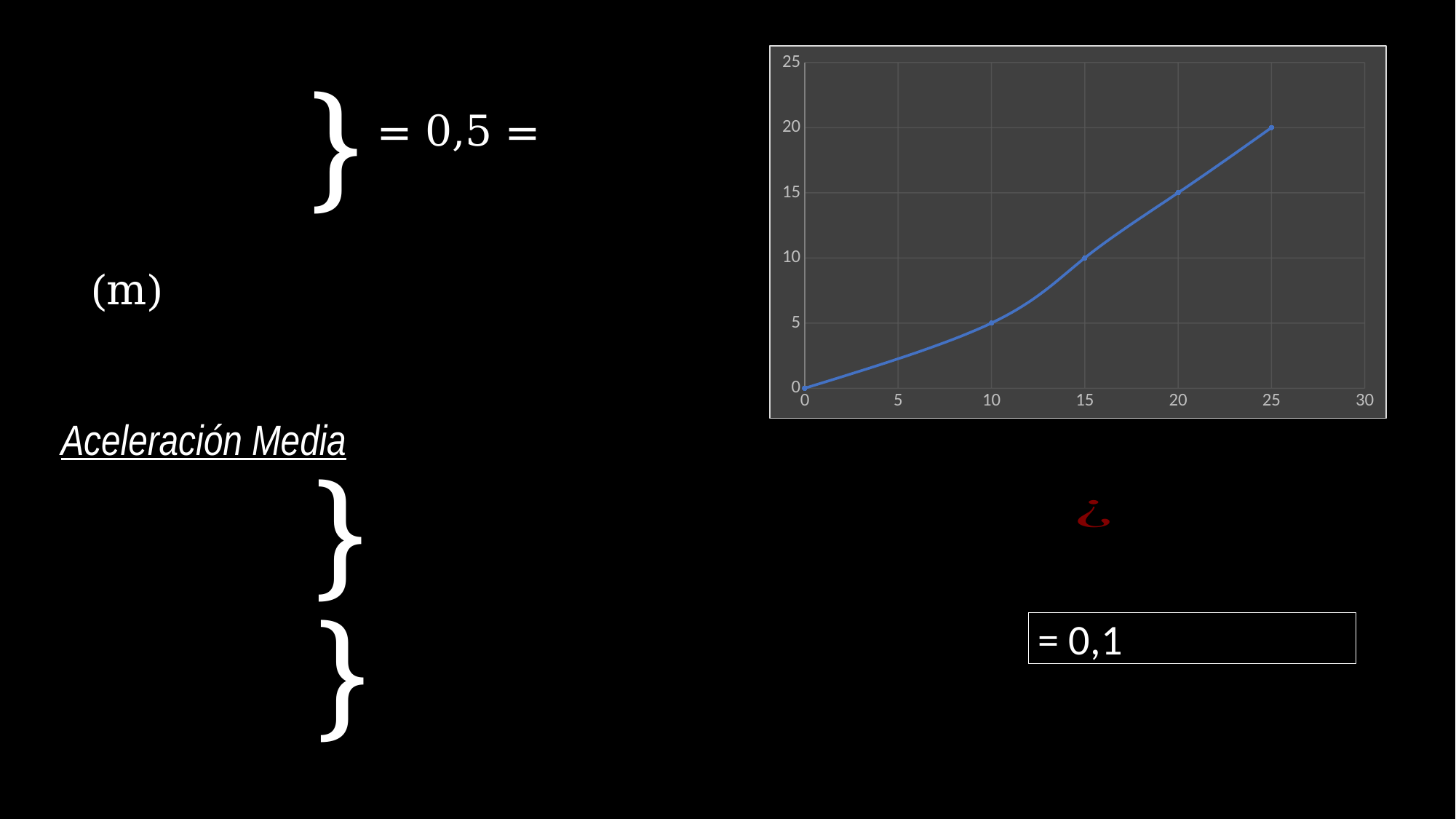
Which x value has the lowest y value on the line chart? 0 Which x value has the highest y value on the line chart? 25 What is the y value of the point at x = 20 on the line chart? 15 What is the y value of the point at x = 10 on the line chart? 5 Do the values on the line chart rise or fall as x increases? rise What is the y value of the point at x = 25 on the line chart? 20 What is the difference between the y values at x = 25 and x = 10 on the line chart? 15 What is the y value of the point at x = 0 on the line chart? 0 How many data points are plotted on the line chart? 5 What is the y value of the point at x = 15 on the line chart? 10 What kind of chart is shown on the slide? line chart What is the highest value shown on the y axis of the line chart? 25